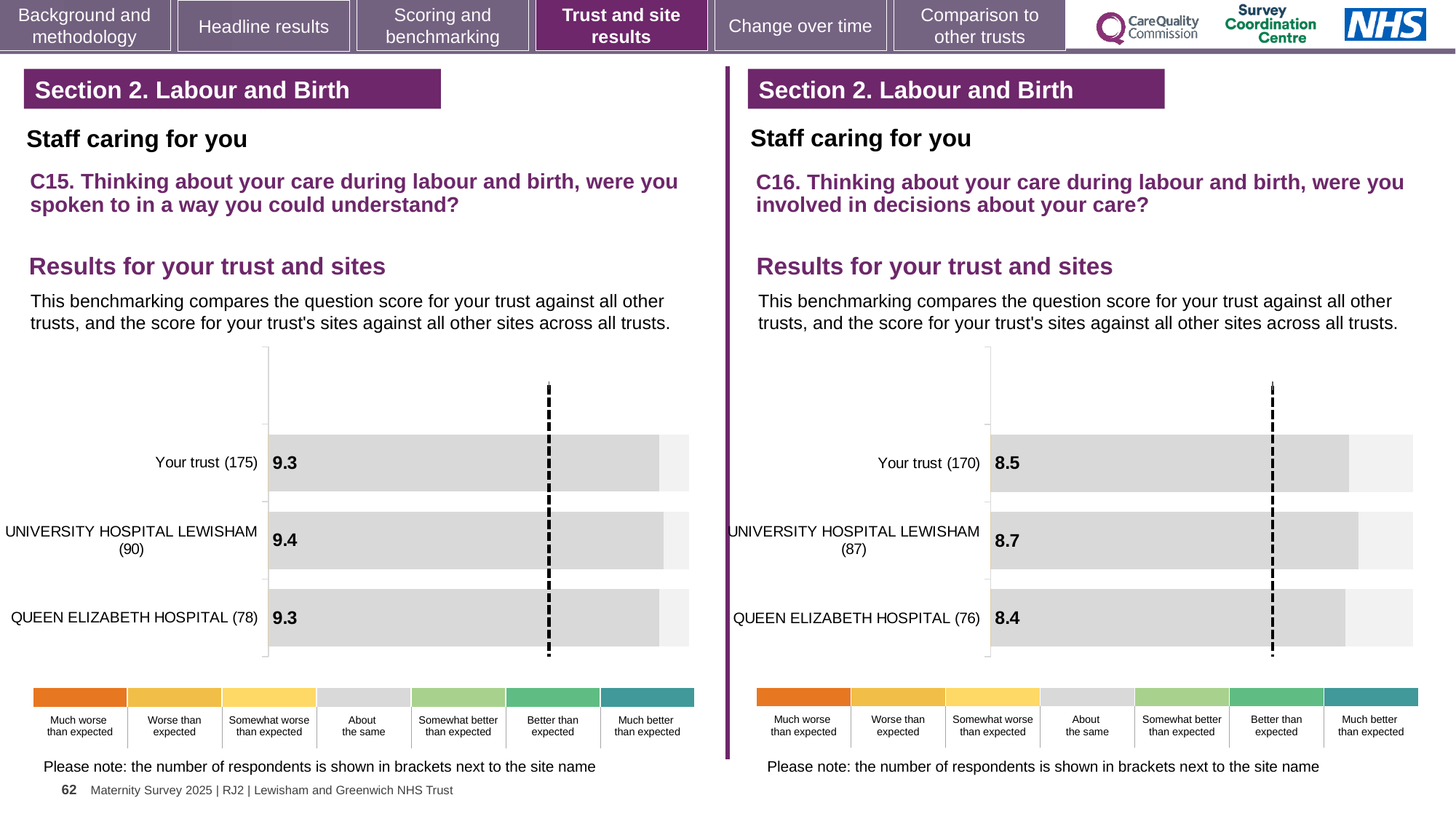
In the C15 chart on the left, how many respondents are shown in brackets for Queen Elizabeth Hospital? 78 How many bars are shown in the C15 chart on the left? 3 In the C15 chart on the left, which site or trust has the highest score? University Hospital Lewisham In the C15 chart on the left, what is the score for Your trust? 9.3 In the C16 chart on the right, which site or trust has the highest score? University Hospital Lewisham In the C16 chart on the right, what is the difference between the scores for University Hospital Lewisham and Queen Elizabeth Hospital? 0.3 In the C15 chart on the left, which has the larger score: Your trust or University Hospital Lewisham? University Hospital Lewisham In the C15 chart on the left, what is the score for University Hospital Lewisham? 9.4 In the C16 chart on the right, what is the score for Your trust? 8.5 What kind of chart is used in the C16 chart on the right? Bar chart In the C16 chart on the right, which site or trust has the lowest score? Queen Elizabeth Hospital In the C16 chart on the right, what is the score for Queen Elizabeth Hospital? 8.4